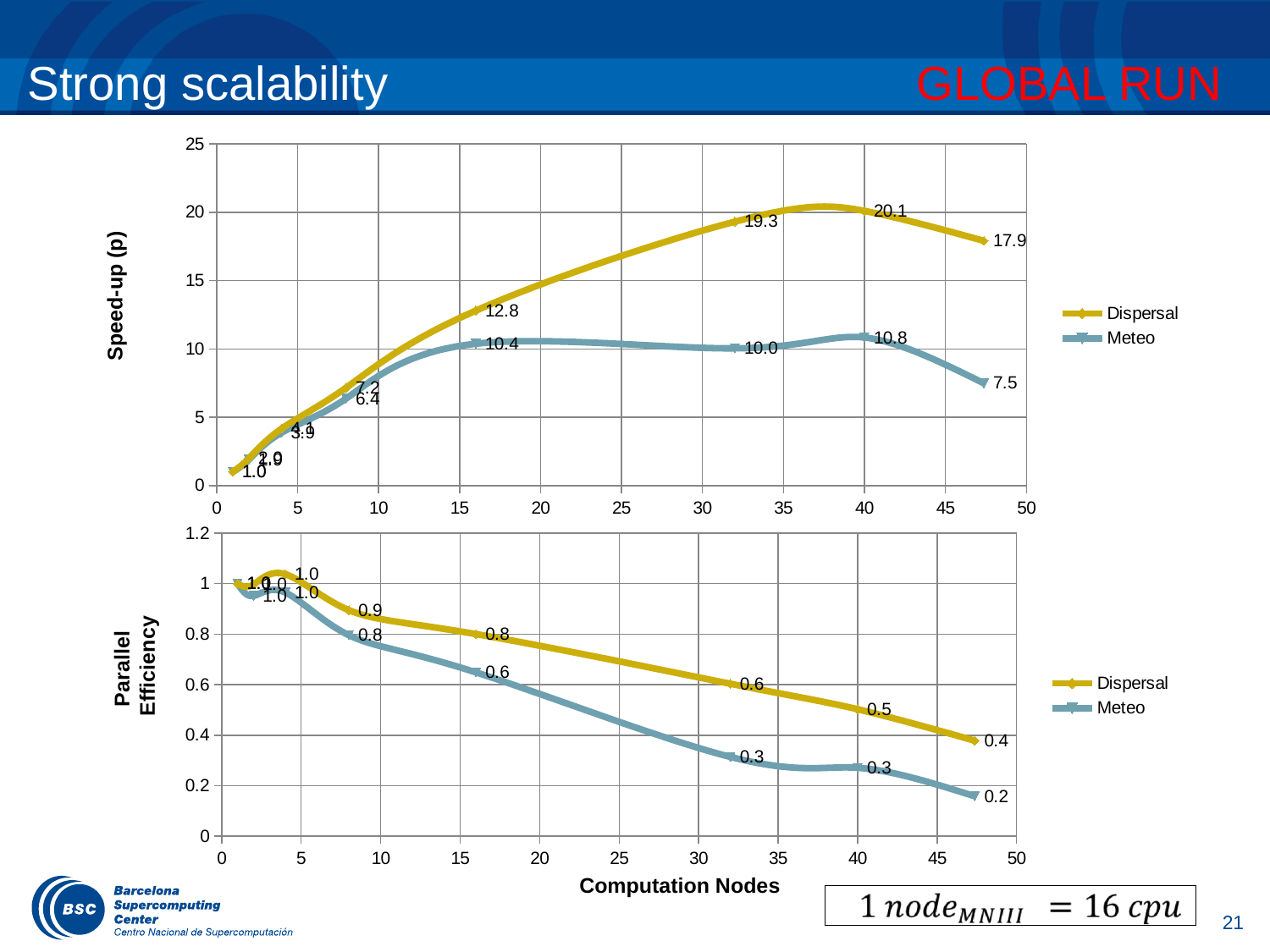
In the bottom Parallel Efficiency chart, what is the efficiency of the Meteo series at its rightmost point (highest node count)? 0.2 In the top Speed-up chart, what is the difference between the Dispersal and Meteo speed-ups at the rightmost point (17.9 vs 7.5)? 10.4 In the bottom Parallel Efficiency chart, what is the efficiency of the Dispersal series at its rightmost point (highest node count)? 0.4 In the top Speed-up chart, what is the highest speed-up value labelled for the Dispersal series? 20.1 In the top Speed-up chart, what is the speed-up of the Meteo series at its rightmost point (highest node count)? 7.5 In the top Speed-up chart, which series reaches the higher speed-up at around 32 nodes, Dispersal or Meteo? Dispersal What is the label of the x axis shared by the two charts? Computation Nodes What kind of chart is the bottom Parallel Efficiency chart? Line chart In the bottom Parallel Efficiency chart, does the Meteo efficiency generally rise or fall as the number of computation nodes increases? Fall In the top Speed-up chart, what is the speed-up of the Dispersal series at its rightmost point (highest node count)? 17.9 In the top Speed-up chart, what is the highest speed-up value labelled for the Meteo series? 10.8 How many series does the legend of the top Speed-up chart list? 2